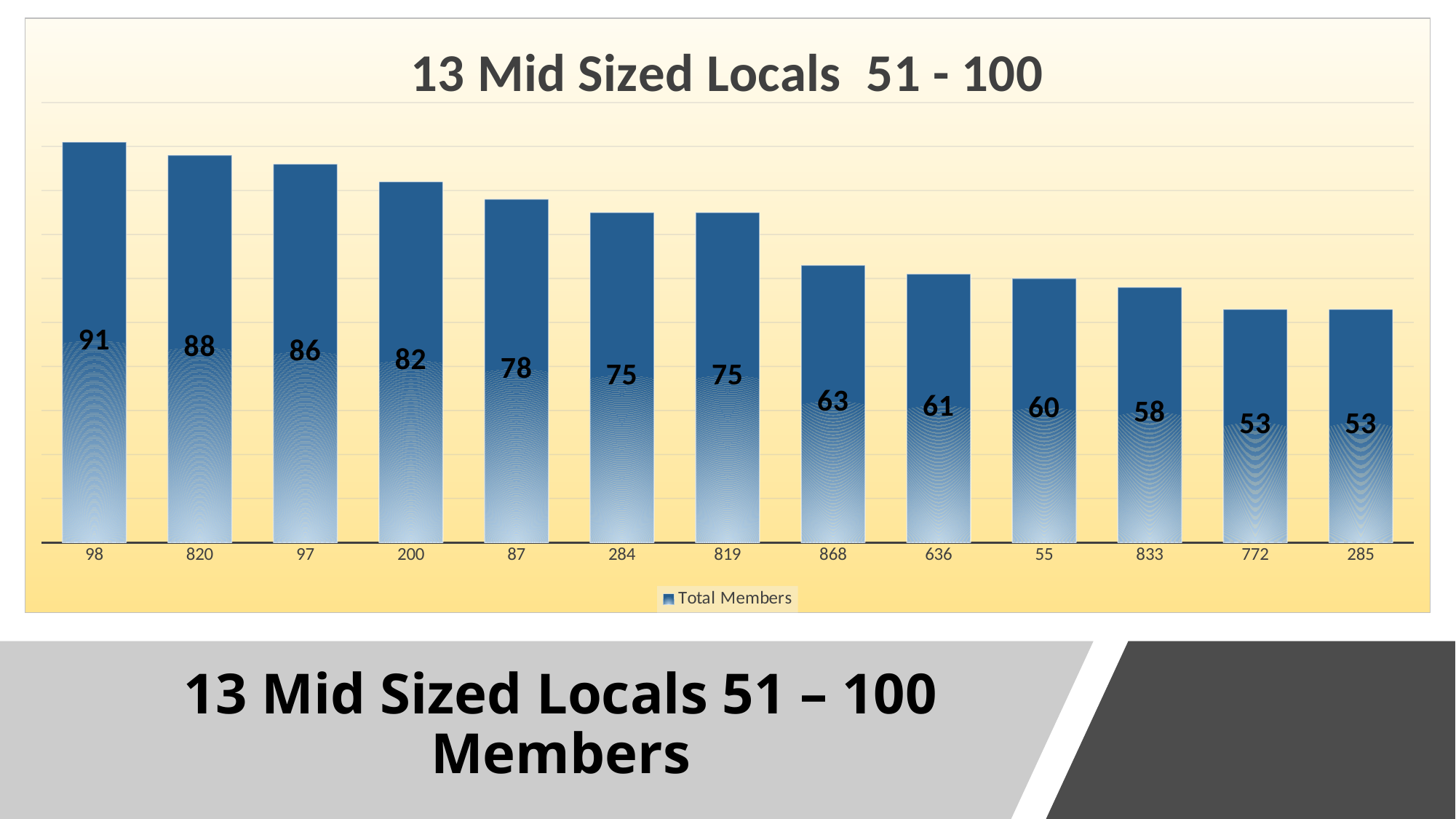
What is the difference between the values for local 820 and local 833? 30 What is the value for local 98? 91 How many locals are shown in the chart? 13 Which has a larger value, local 200 or local 636? 200 Which local has the highest number of total members? 98 What series name is shown in the legend? Total Members Do the values rise or fall from left to right along the x axis? Fall What is the title of the chart? 13 Mid Sized Locals 51 - 100 What kind of chart is shown? Bar chart What is the value for local 55? 60 What is the value for local 868? 63 How many series does the legend list? 1